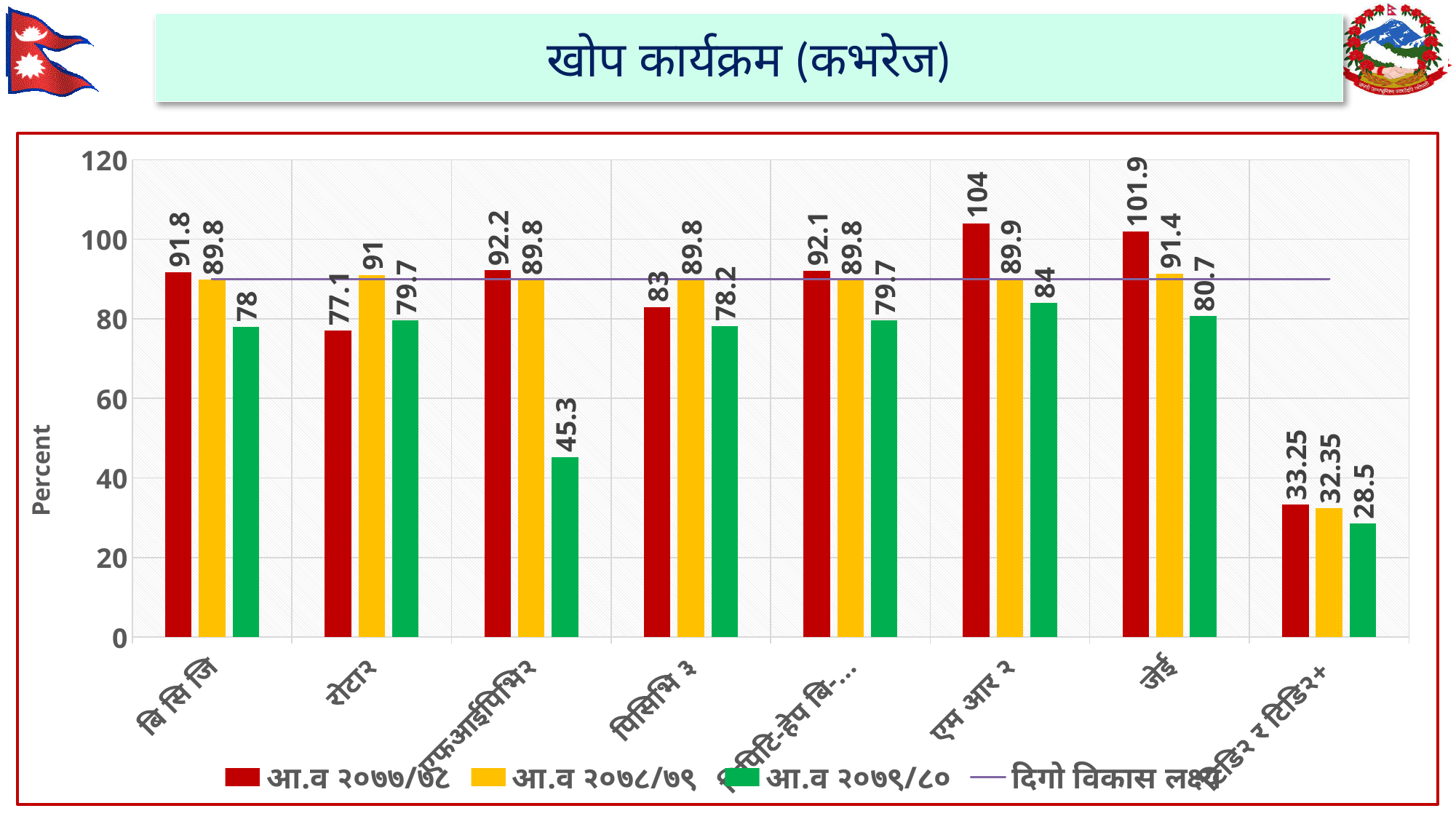
What is the difference between the आ.व २०७७/७८ and आ.व २०७९/८० values for एम आर २? 20 What is the value for बि सि जि in the आ.व २०७७/७८ series? 91.8 What type of chart is shown on the slide? Bar chart with a line (combination bar and line chart) What is the label of the y axis? Percent Which category has the highest value in the आ.व २०७७/७८ series? एम आर २ For रोटा२, which is larger: the आ.व २०७७/७८ value or the आ.व २०७८/७९ value? आ.व २०७८/७९ Which category has the lowest value in the आ.व २०७९/८० series? टिडि२ र टिडि२+ What is the value for जेई in the आ.व २०७८/७९ series? 91.4 What is the value for एफआईपिभि२ in the आ.व २०७९/८० series? 45.3 Is the आ.व २०७९/८० value for पिसिभि ३ greater or less than 80? less How many categories are shown on the x axis? 8 How many entries does the legend list? 4